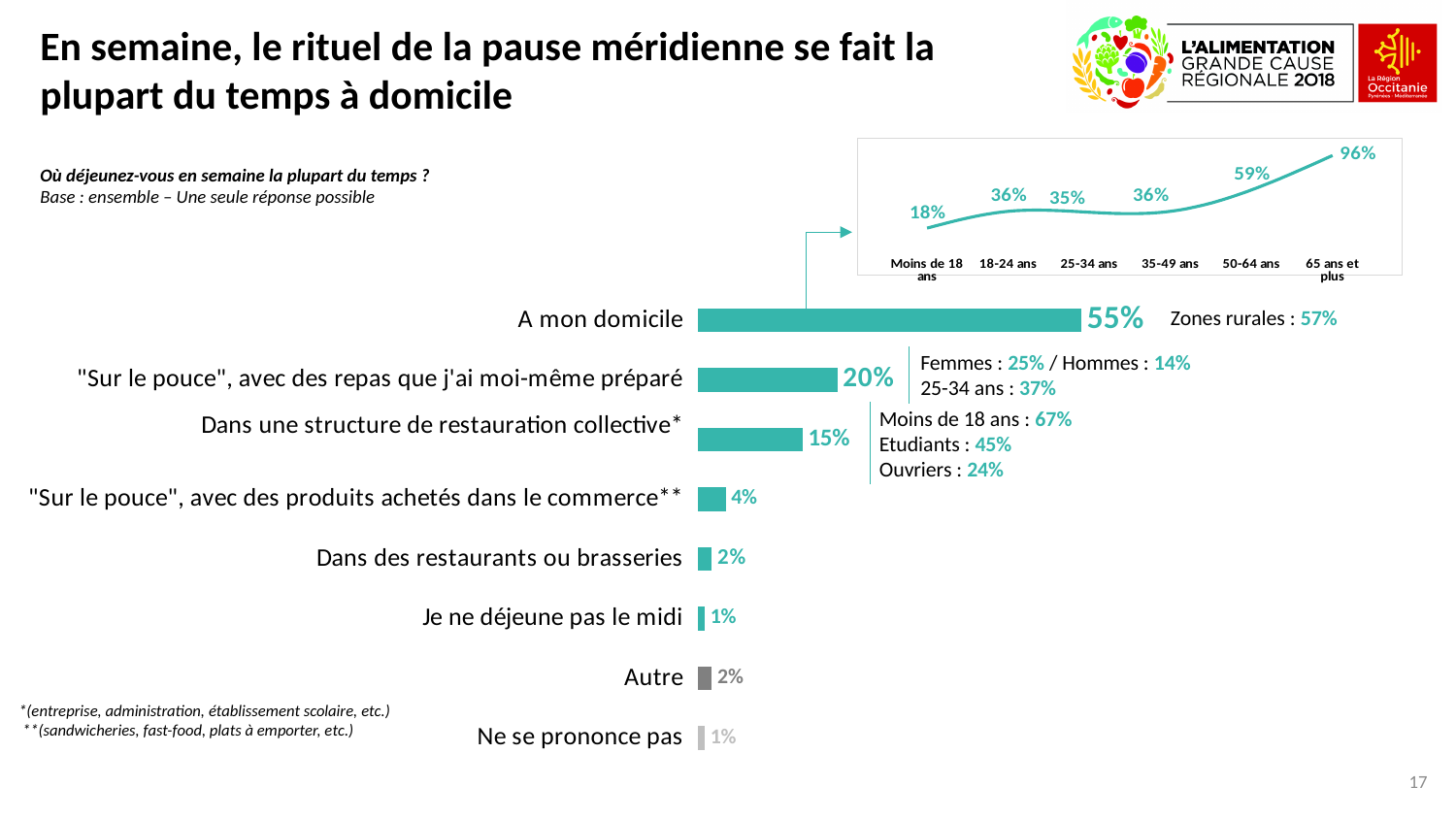
In the main bar chart, what is the value for "A mon domicile"? 55% In the main bar chart, what is the difference between "A mon domicile" and "Sur le pouce, avec des repas que j'ai moi-même préparé"? 35 percentage points In the small line chart at the top right, what is the value for "65 ans et plus"? 96% In the main bar chart, which is larger: "Sur le pouce, avec des produits achetés dans le commerce**" or "Dans des restaurants ou brasseries"? Sur le pouce, avec des produits achetés dans le commerce** What kind of chart is the main chart on the slide? Bar chart How many age groups are plotted in the small line chart at the top right? 6 How many categories does the main bar chart show? 8 In the small line chart at the top right, what is the value for "Moins de 18 ans"? 18% In the main bar chart, which category has the highest value? A mon domicile In the small line chart at the top right, what is the difference between "50-64 ans" and "35-49 ans"? 23 percentage points In the small line chart at the top right, which age group has the lowest value? Moins de 18 ans In the main bar chart, what is the value for "Dans une structure de restauration collective*"? 15%